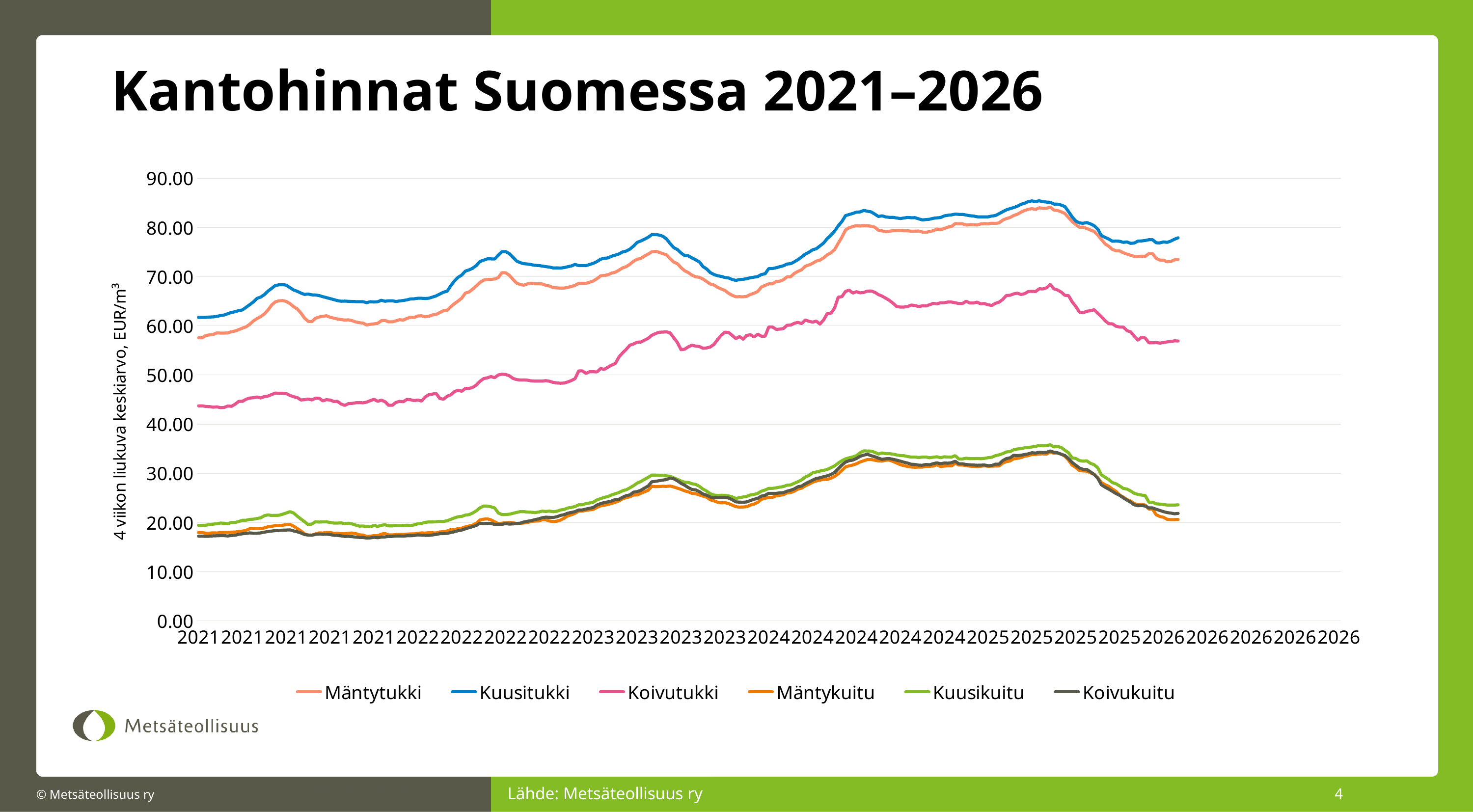
What is the title of the chart? Kantohinnat Suomessa 2021–2026 What kind of chart is shown on the slide? Line chart Is the value for Kuusikuitu at the start of 2021 greater or less than 30.00? less Is the value for Koivutukki at the start of 2021 greater or less than 50.00? less Does the Koivutukki series rise or fall from the start of 2021 to the start of 2025? rise What is the label on the vertical axis of the chart? 4 viikon liukuva keskiarvo, EUR/m³ Is the peak value of Koivutukki in 2025 greater or less than 60.00? greater Which series is higher throughout the chart, Kuusitukki or Mäntytukki? Kuusitukki Which series reaches the highest value on the chart? Kuusitukki Which series is higher at the end of the chart in 2026, Kuusikuitu or Mäntykuitu? Kuusikuitu How many series does the legend list? 6